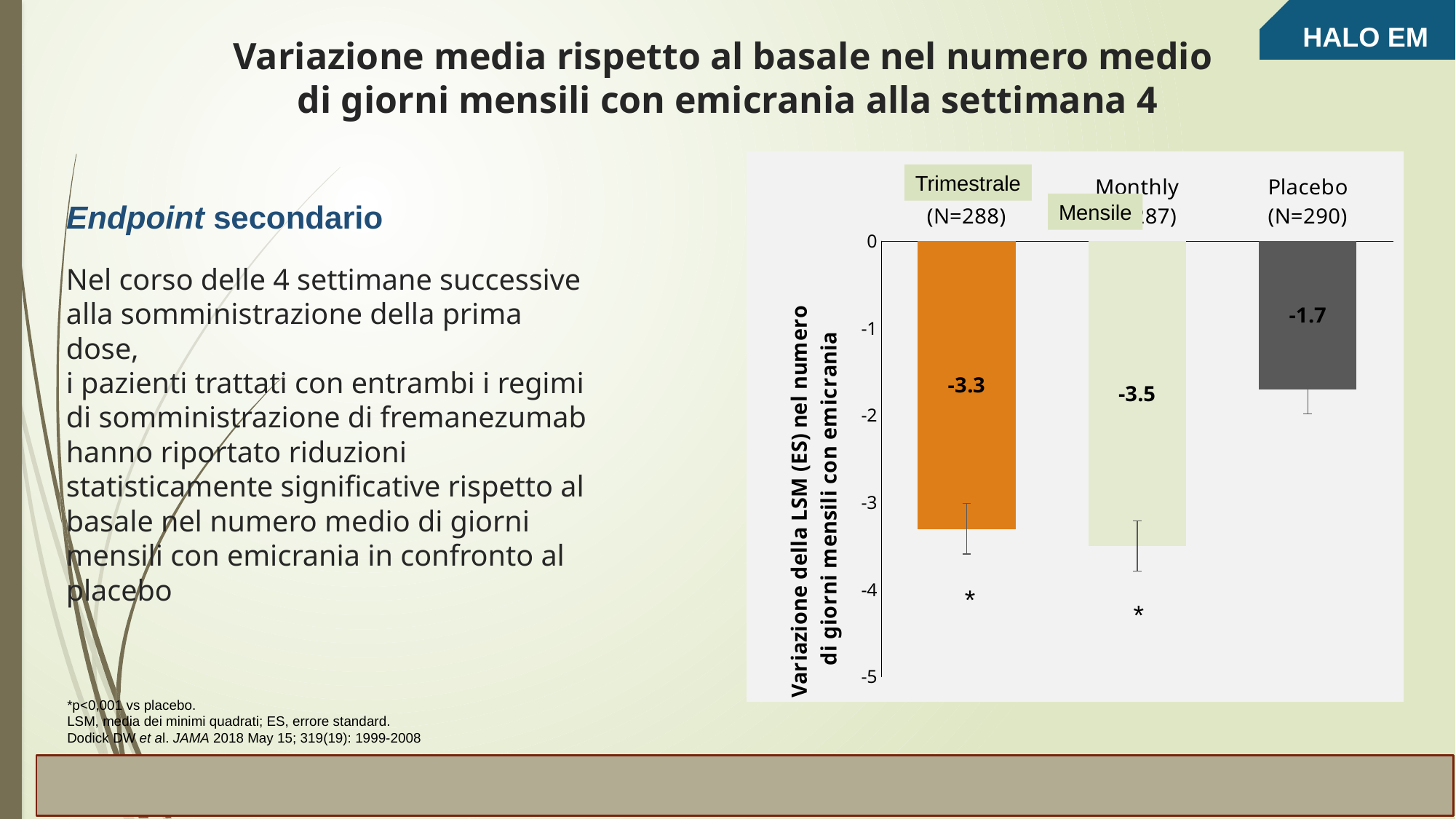
What is the difference between the Mensile value (-3.5) and the Placebo value (-1.7)? 1.8 Which bar has the smallest reduction (value closest to zero)? Placebo What is the number of patients (N) shown for the Placebo group? 290 What is the value shown for the Placebo (N=290) bar? -1.7 What is the value shown for the Mensile bar? -3.5 Is the Placebo bar value greater or less than -2 on the axis? greater What is the difference between the Trimestrale value (-3.3) and the Placebo value (-1.7)? 1.6 Which bar extends furthest below zero (the largest reduction)? Mensile What type of chart is shown on the slide? Bar chart How many bars are plotted in the chart? 3 What is the value shown for the Trimestrale (N=288) bar? -3.3 Which shows a larger reduction from baseline, Trimestrale or Placebo? Trimestrale